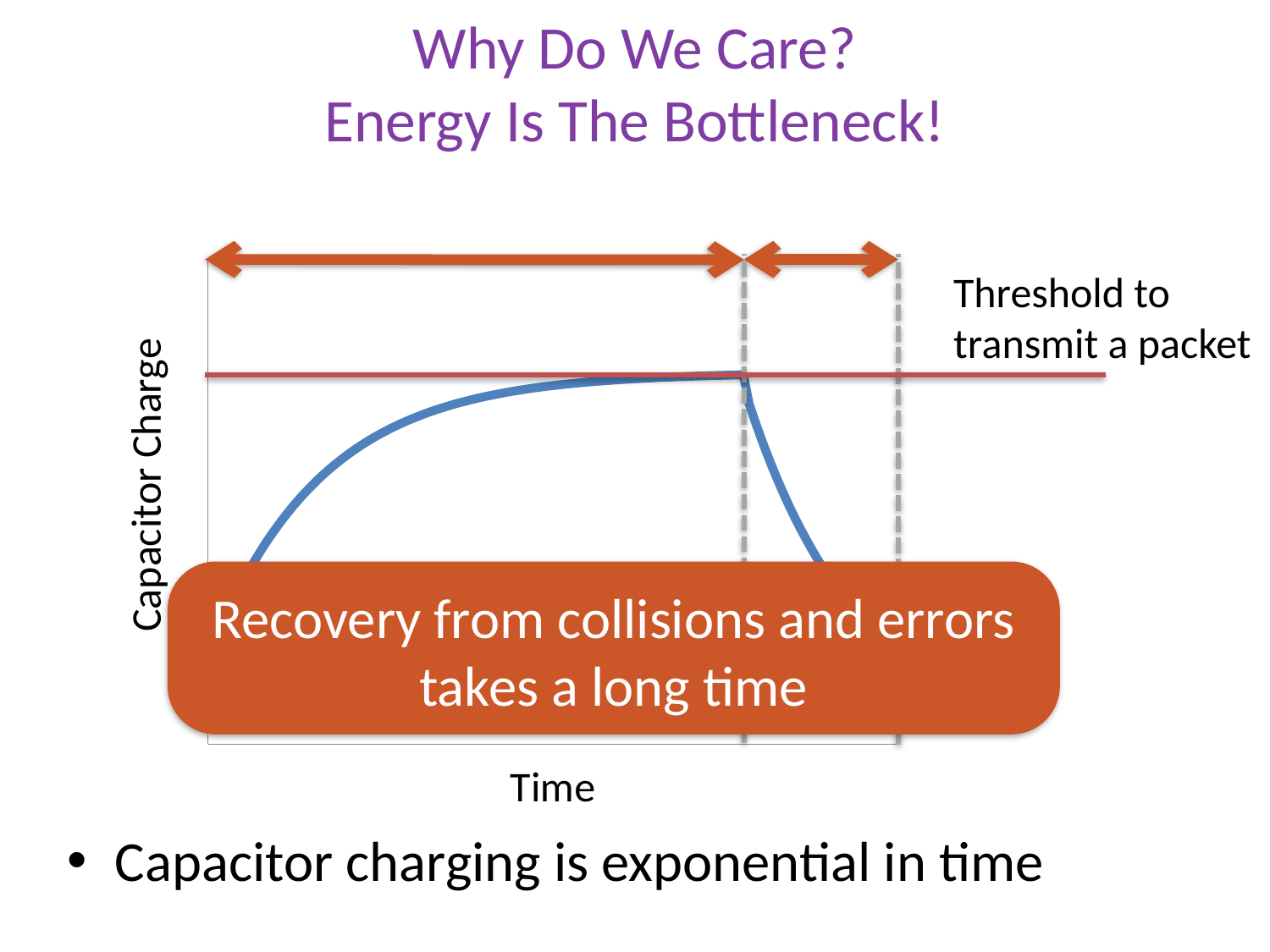
What kind of chart is shown on the slide? line chart What is the label of the vertical axis of the chart? Capacitor Charge After the curve reaches the red threshold line, does the capacitor charge rise or fall? fall How many data curves are plotted on the chart? 1 What does the red horizontal line on the chart represent? Threshold to transmit a packet Before the curve reaches the red threshold line, does the capacitor charge rise or fall along the time axis? rise